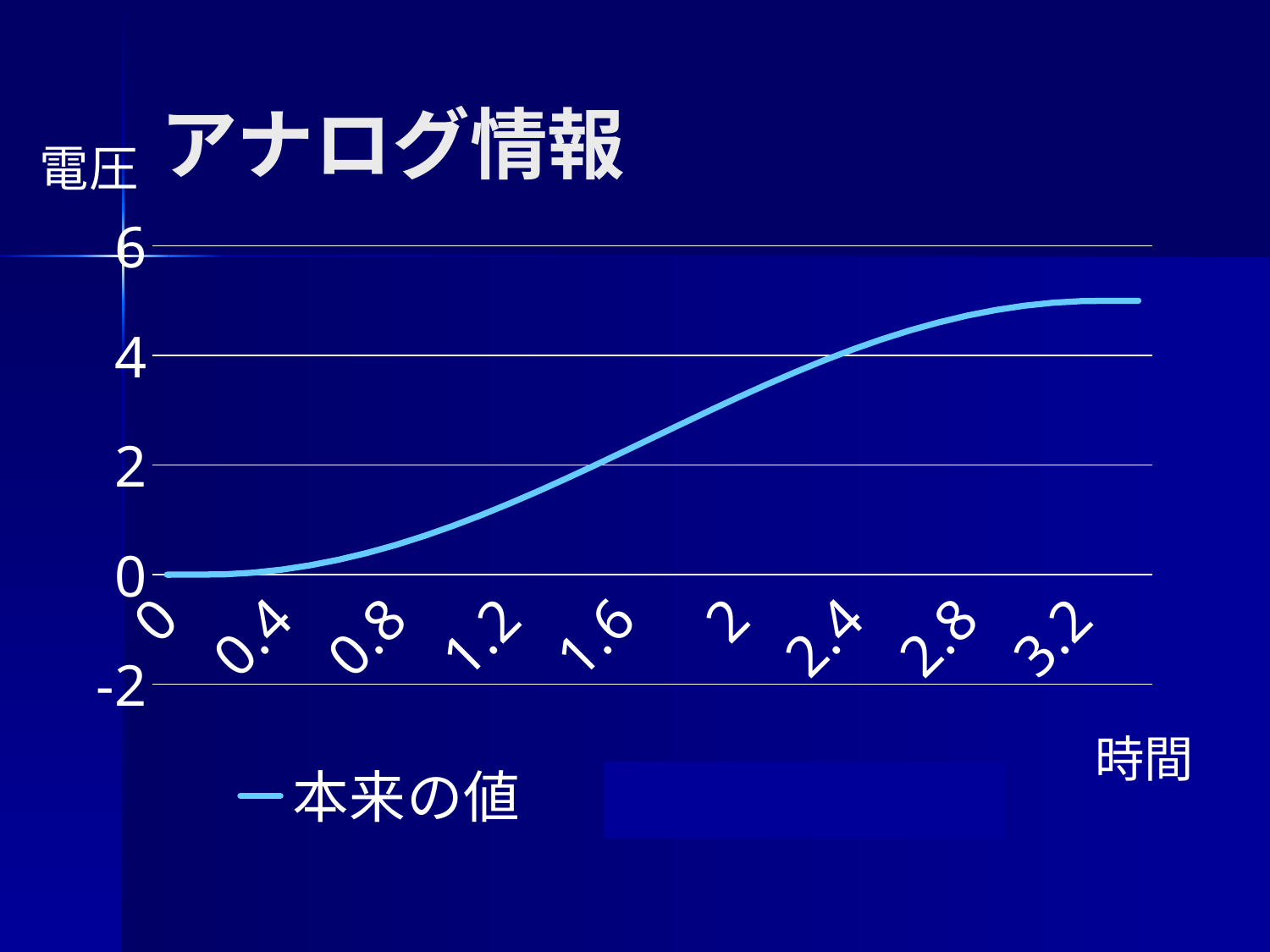
What is the title of the chart? アナログ情報 How many labelled points are there along the x axis? 9 What is the name of the series shown in the legend? 本来の値 How many series does the legend list? 1 At which 時間 value is 本来の値 lowest? 0 Which is larger, the value of 本来の値 at 時間 = 1.2 or at 時間 = 2.4? 2.4 What is the value of 本来の値 at 時間 = 0? 0 Is the value of 本来の値 at 時間 = 2.8 greater or less than 4? greater What kind of chart is shown on the slide? line chart Is the value of 本来の値 at 時間 = 0.8 greater or less than 2? less Do the values of 本来の値 rise or fall as 時間 increases along the x axis? rise